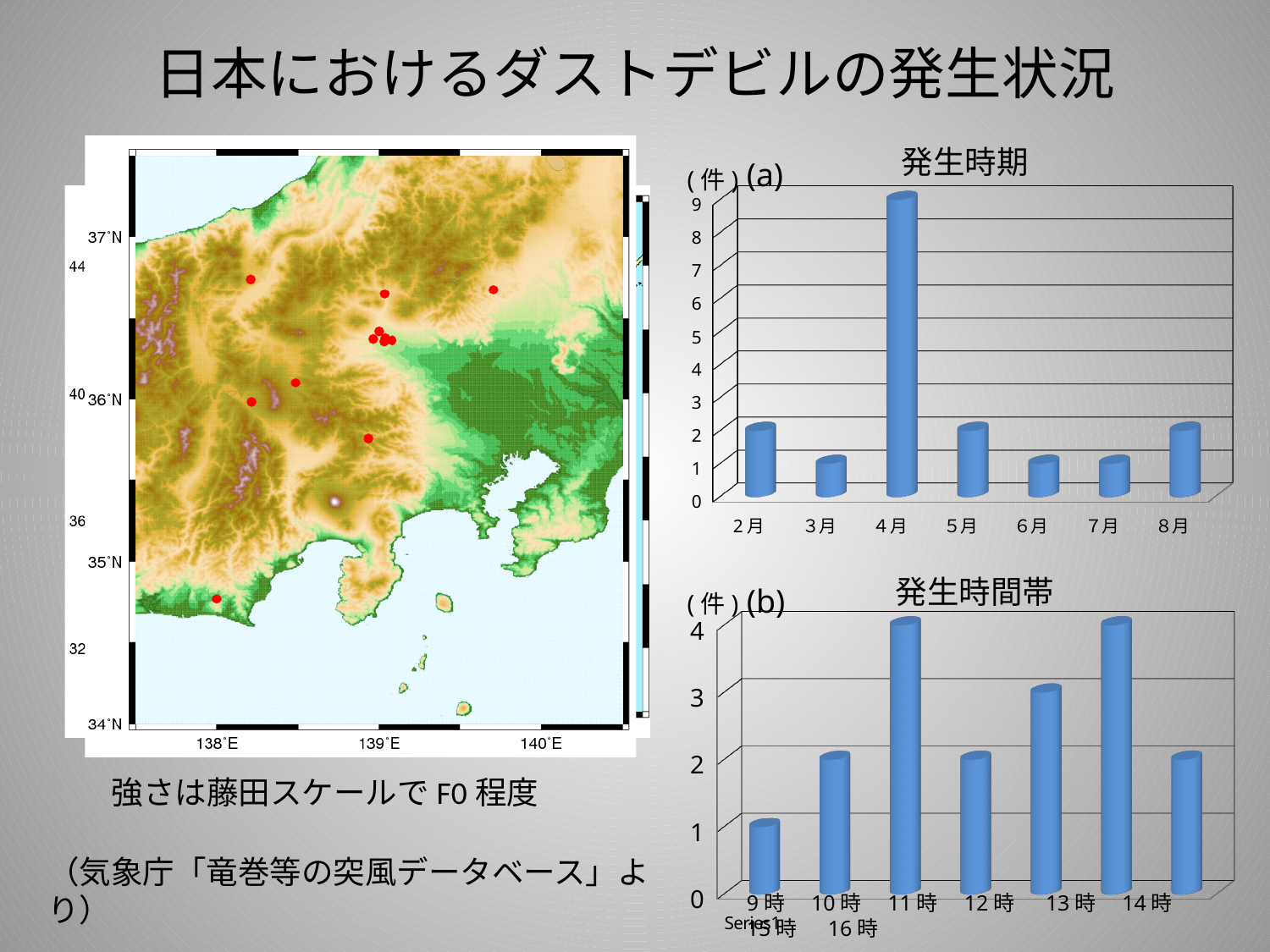
In the chart titled 発生時期 (a), which is larger, the value for 2月 or the value for 3月? 2月 In the chart titled 発生時間帯 (b), what is the value for 13時? 3 In the chart titled 発生時期 (a), is the value for 4月 greater or less than 8? greater In the chart titled 発生時期 (a), what is the value for 2月? 2 In the chart titled 発生時間帯 (b), which is larger, the value for 11時 or the value for 13時? 11時 In the chart titled 発生時期 (a), what is the difference between the values for 4月 and 5月? 7 In the chart titled 発生時期 (a), which month has the highest value? 4月 In the chart titled 発生時期 (a), what is the value for 4月? 9 What kind of chart is the chart titled 発生時期 (a)? bar chart In the chart titled 発生時期 (a), how many months are shown on the x axis? 7 What unit label is shown at the top of the vertical axis of the chart titled 発生時間帯 (b)? (件) In the chart titled 発生時間帯 (b), what is the value for 11時? 4